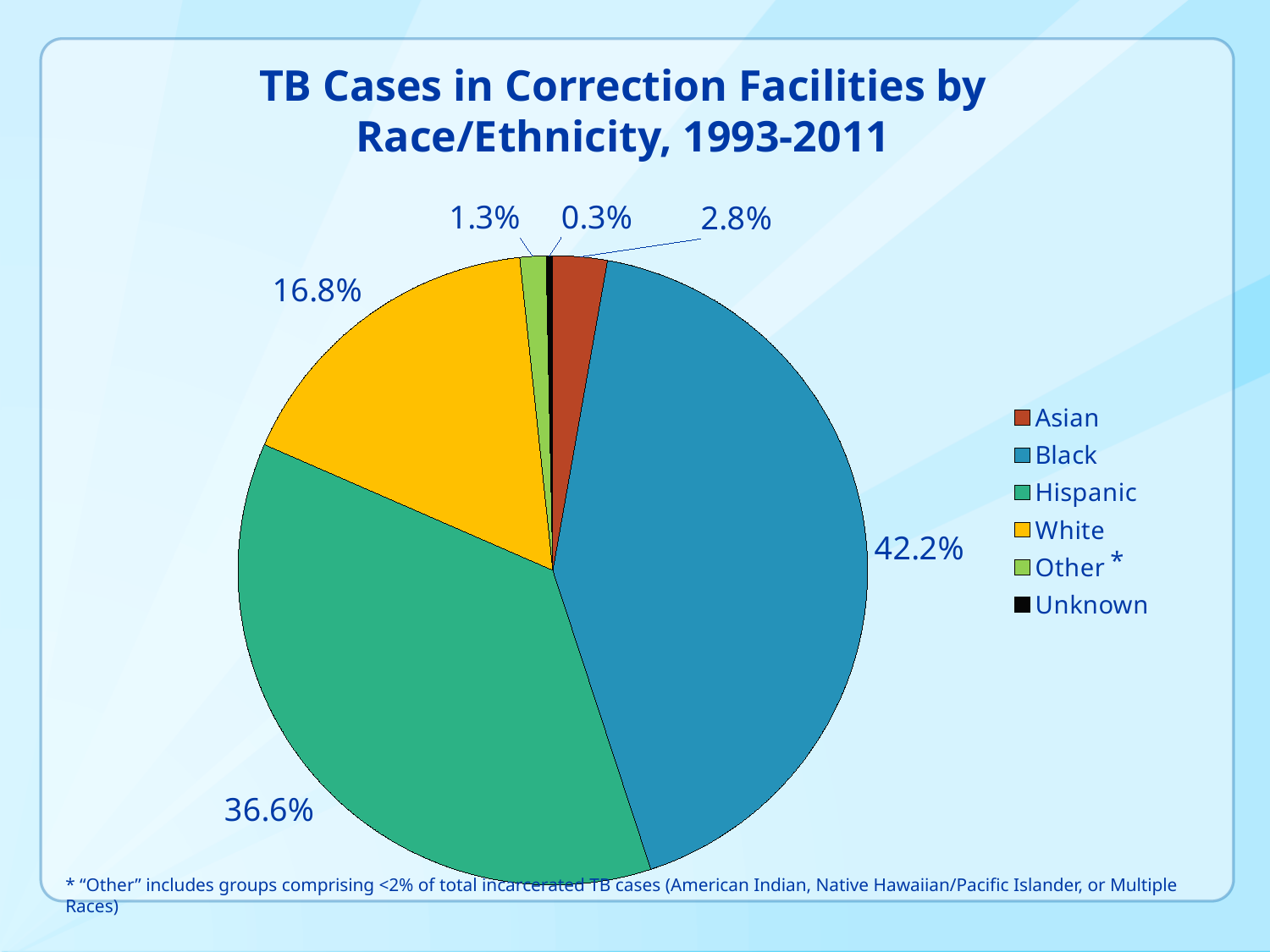
What is the title of the chart? TB Cases in Correction Facilities by Race/Ethnicity, 1993-2011 How many race/ethnicity categories does the legend list? 6 Which race/ethnicity category has the smallest share of TB cases in correction facilities? Unknown Which is larger, the share for White or the share for Asian? White What percentage of TB cases in correction facilities were among Black individuals? 42.2% What percentage of TB cases in correction facilities were among Hispanic individuals? 36.6% What type of chart is shown on the slide? Pie chart Which race/ethnicity category has the largest share of TB cases in correction facilities? Black What percentage is shown for the Unknown slice? 0.3% What is the difference in percentage points between the Black and Hispanic shares? 5.6 What share of the pie is labelled for White? 16.8% What percentage is shown for the Asian slice? 2.8%